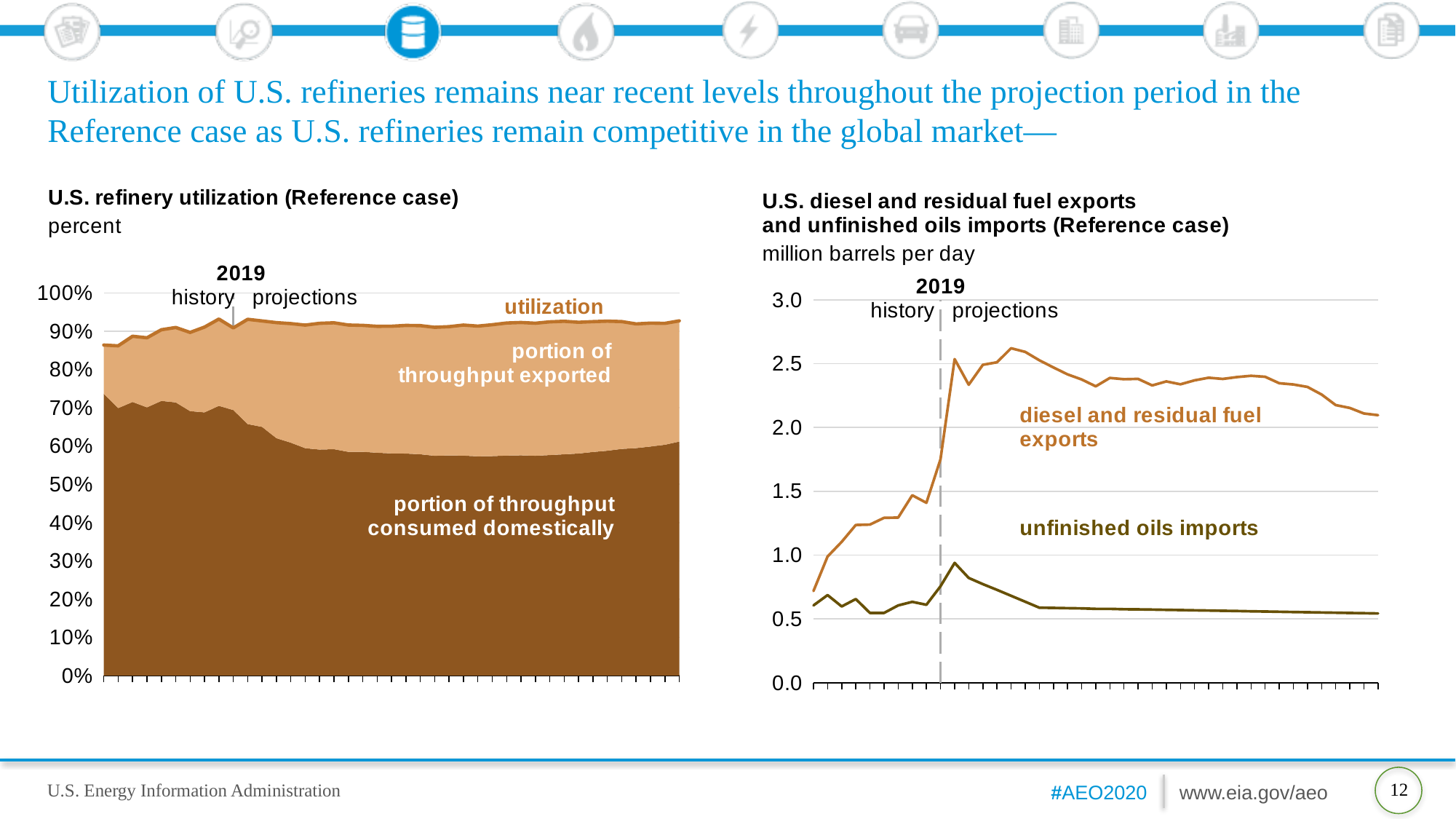
In the right chart, which series is higher throughout the projection period: diesel and residual fuel exports or unfinished oils imports? diesel and residual fuel exports In the right chart, do diesel and residual fuel exports rise or fall over the history period? rise In the right chart, what unit is shown on the y axis? million barrels per day In the right chart, is the value for unfinished oils imports at the end of the projection period greater or less than 1.0? less What kind of chart is the right chart, 'U.S. diesel and residual fuel exports and unfinished oils imports (Reference case)'? line chart In the right chart, how many data series are labeled? 2 In the left chart, does the portion of throughput consumed domestically rise or fall from the start of the history period to the end of the projection period? fall In the left chart, is the utilization value at the end of the projection period greater or less than 80%? greater In the left chart, which year separates history from projections? 2019 In the left chart, is the portion of throughput consumed domestically at the start of the history period greater or less than 70%? greater What kind of chart is the left chart, 'U.S. refinery utilization (Reference case)'? stacked area chart